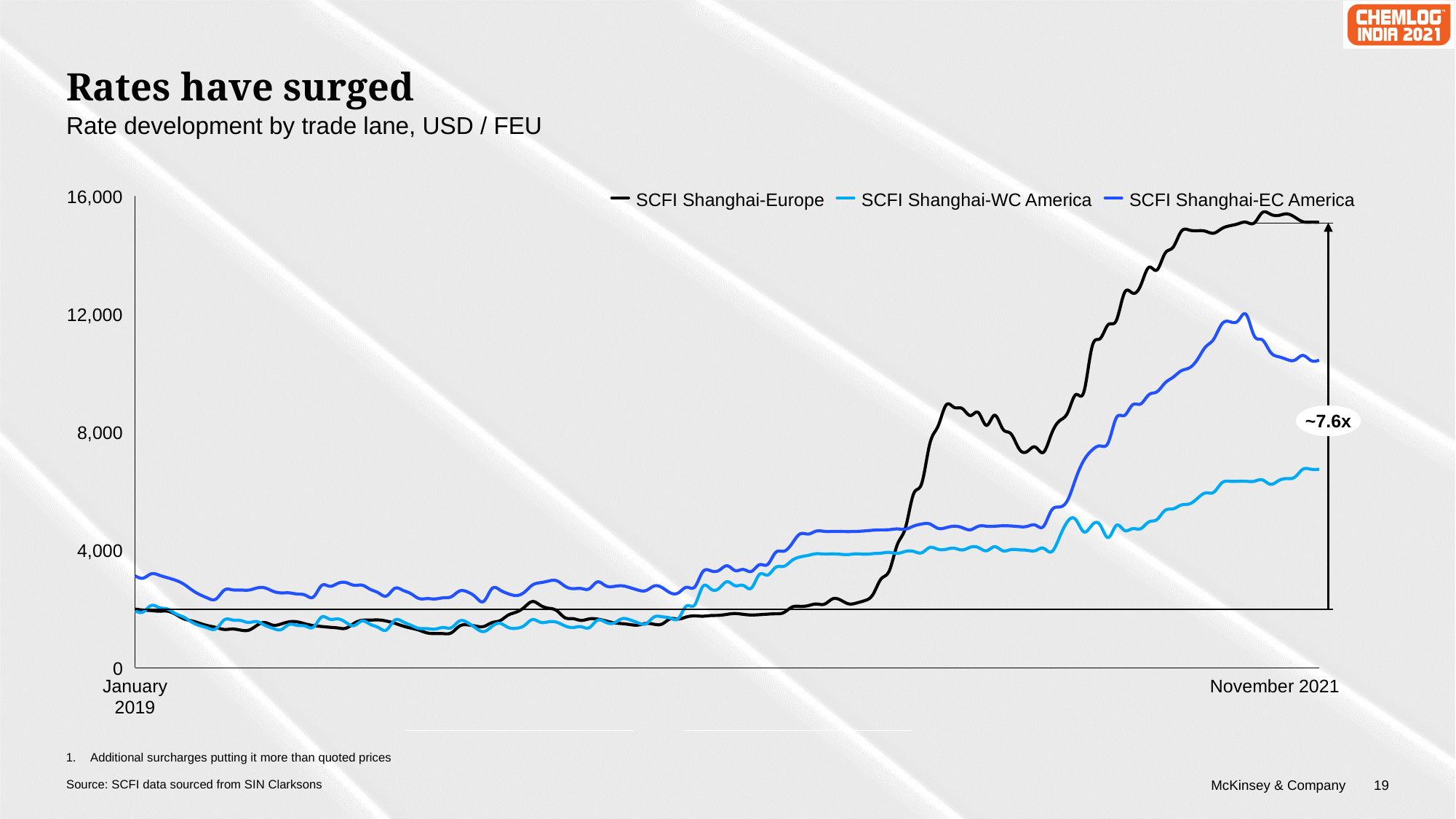
Is the value for SCFI Shanghai-Europe in January 2019 greater or less than 4,000? less At November 2021, which is larger: SCFI Shanghai-Europe or SCFI Shanghai-WC America? SCFI Shanghai-Europe In what unit are the rates on the chart expressed? USD / FEU Is the value for SCFI Shanghai-WC America at November 2021 greater or less than 8,000? less Do the rates generally rise or fall from January 2019 to November 2021? rise Is the value for SCFI Shanghai-EC America at November 2021 greater or less than 8,000? greater How many series does the legend list? 3 Which series has the lowest value at November 2021? SCFI Shanghai-WC America What kind of chart is shown on the slide? line chart Which series reaches the highest value on the chart? SCFI Shanghai-Europe What multiple does the annotation on the right of the chart show for the increase in the SCFI Shanghai-Europe rate? ~7.6x